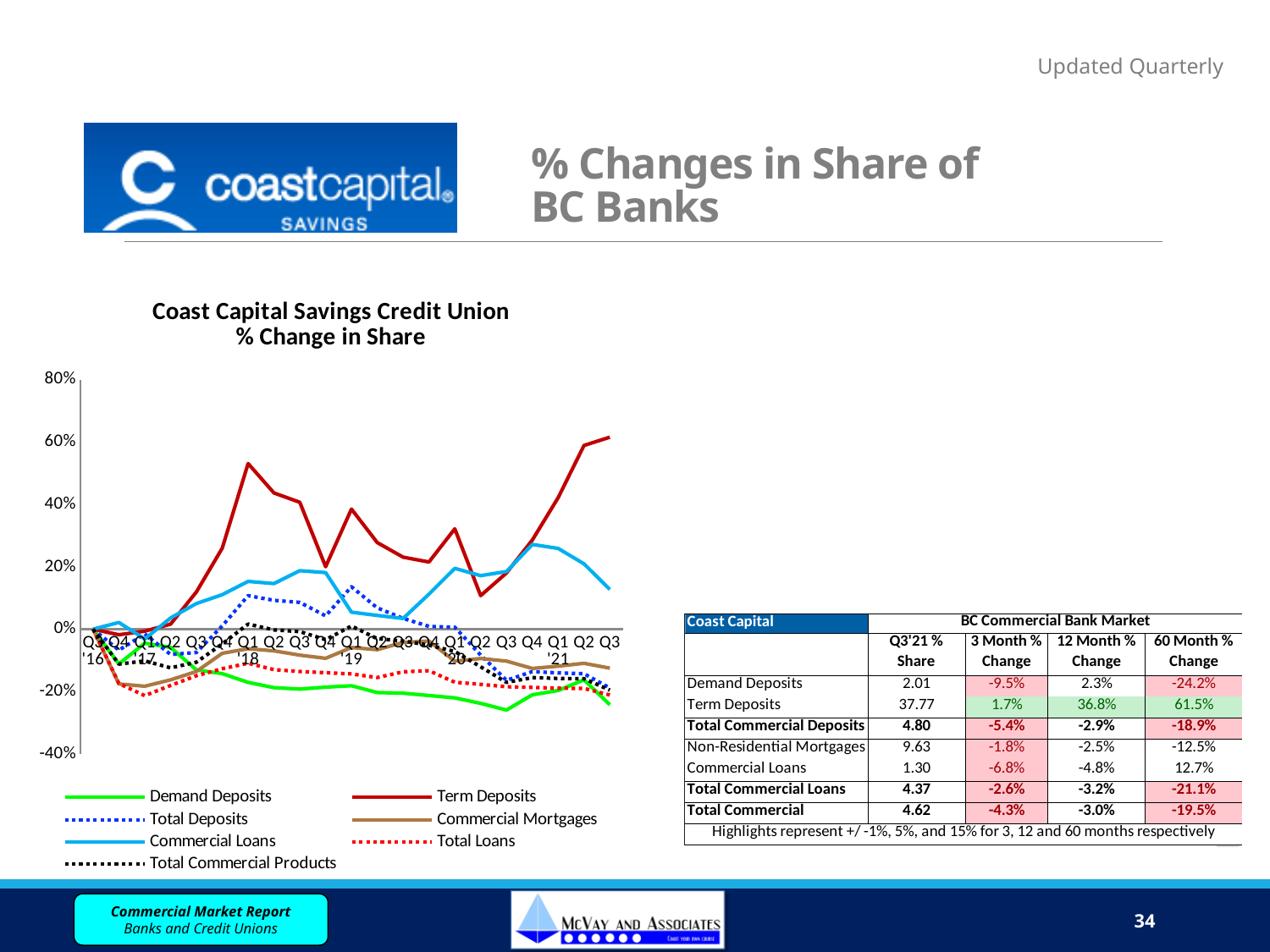
Does the Term Deposits line rise or fall from Q1 '20 to Q3 '21? rise Is the value for Term Deposits at Q3 '21 greater or less than 40%? greater Which series reaches the highest value on the chart? Term Deposits How many series does the chart legend list? 7 Which series reaches the lowest value on the chart? Demand Deposits What colour is the Term Deposits line in the chart? red What type of chart is shown on the slide? line chart Is the value for Commercial Loans at Q3 '21 greater or less than 20%? less What is the title of the chart? Coast Capital Savings Credit Union % Change in Share How many quarters are plotted along the x axis of the chart? 21 Is the value for Demand Deposits at Q3 '21 greater or less than 0%? less At Q3 '21, which is larger: Term Deposits or Commercial Loans? Term Deposits